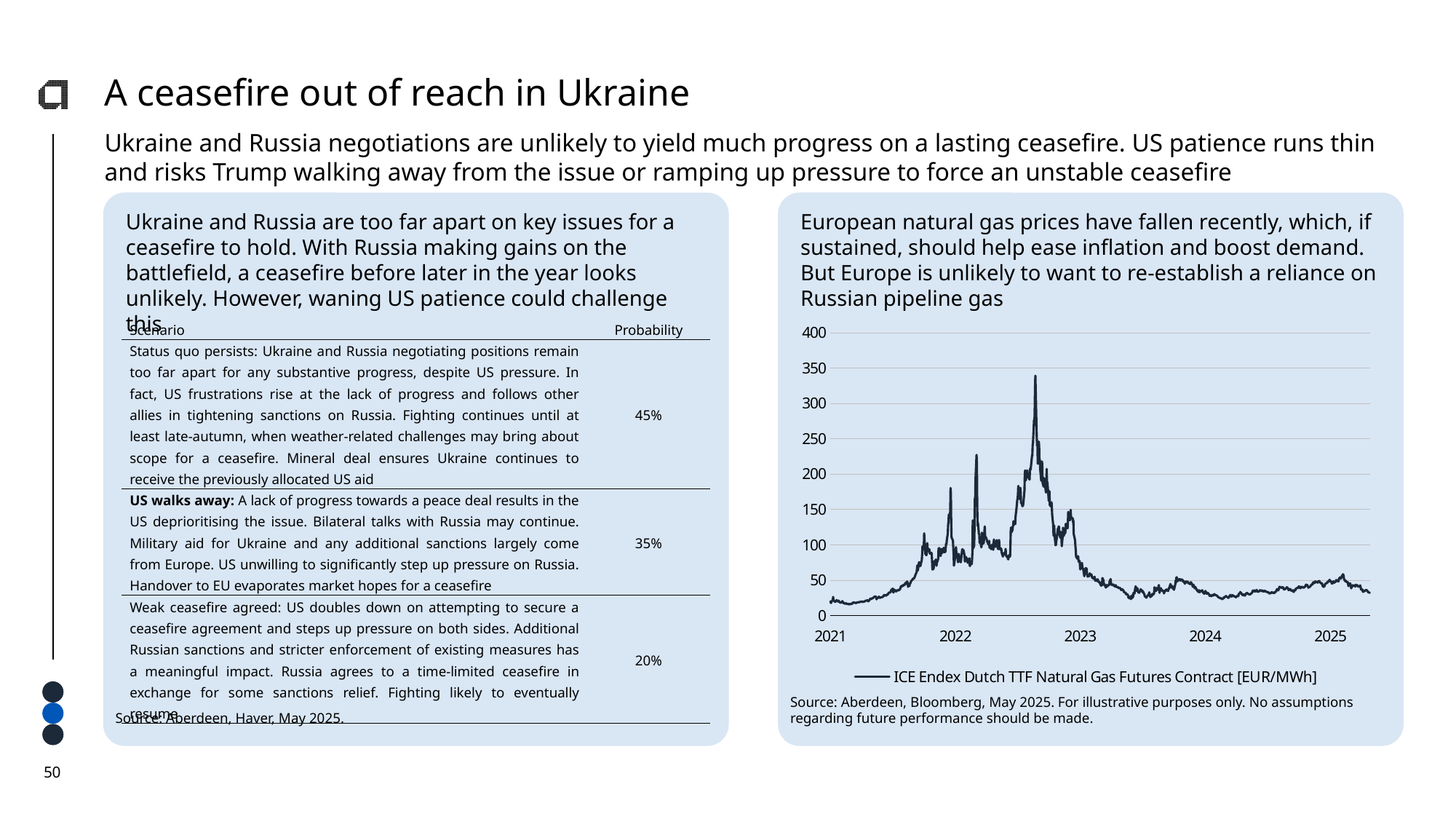
Is the highest peak of the natural gas futures line greater or less than 300? greater How many series does the legend of the natural gas chart list? 1 Is the value of the natural gas futures line at the start of 2021 greater or less than 50? less What is the highest value shown on the y axis of the natural gas chart? 400 Is the value of the natural gas futures line at the 2024 tick greater or less than 50? less What is the legend entry of the line chart on the slide? ICE Endex Dutch TTF Natural Gas Futures Contract [EUR/MWh] From 2021 to the peak in 2022, do the values of the natural gas futures line rise or fall? rise In which year does the natural gas futures line reach its highest peak? 2022 What kind of chart is shown on the right side of the slide? line chart From the 2022 peak to 2025, do the values of the natural gas futures line rise or fall? fall How many year labels are shown on the x axis of the natural gas chart? 5